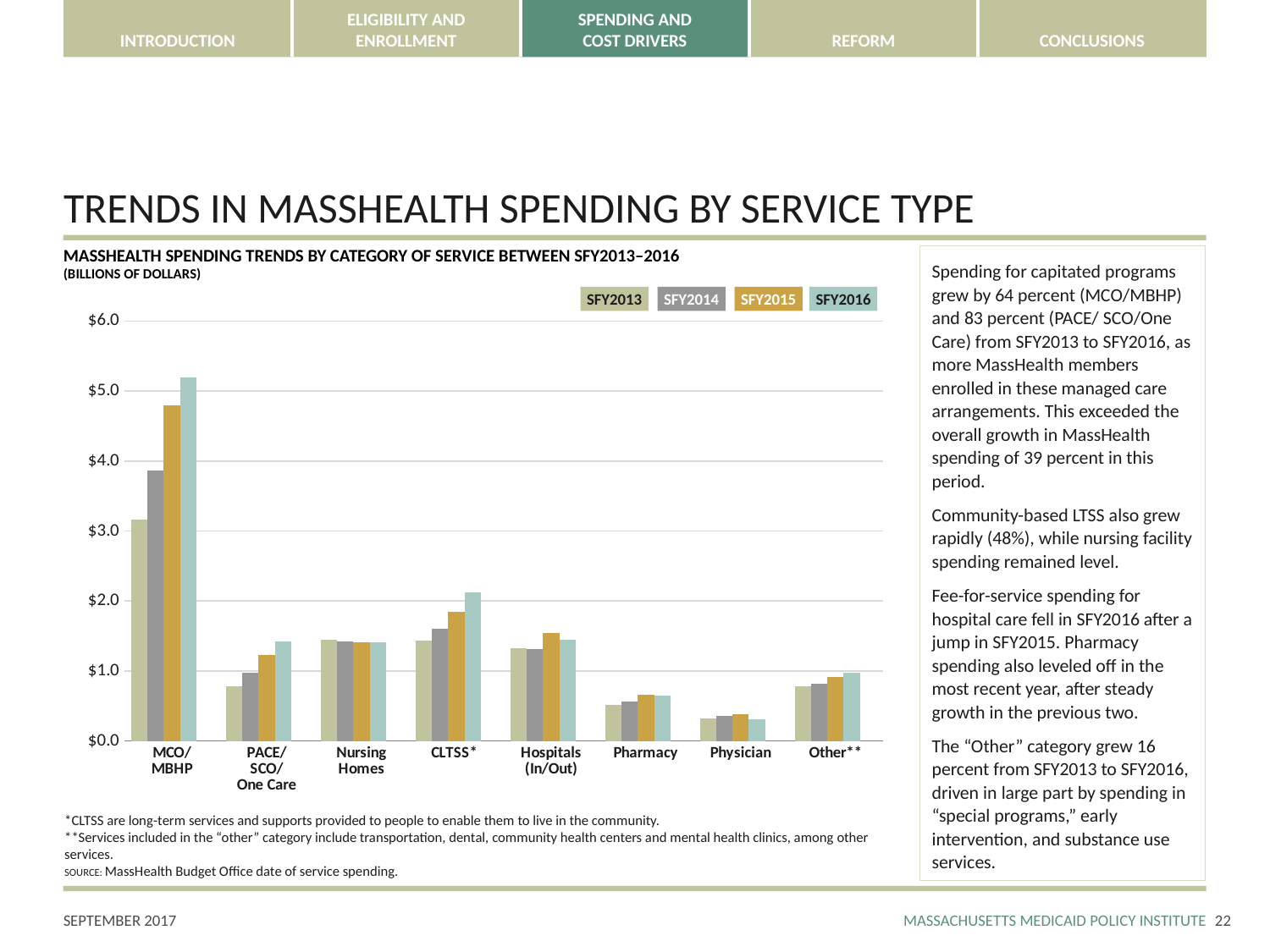
Is the SFY2016 value for MCO/MBHP greater or less than $5.0? greater Which is larger in SFY2016: spending for CLTSS or for Hospitals (In/Out)? CLTSS Which service category has the lowest SFY2016 spending? Physician How many service categories are shown on the x axis of the chart? 8 Do the MCO/MBHP bars rise or fall from SFY2013 to SFY2016? rise Which service category has the highest SFY2016 spending? MCO/MBHP How many series does the chart's legend list? 4 Do the CLTSS bars rise or fall from SFY2013 to SFY2016? rise What kind of chart is shown on the slide? bar chart Is the SFY2015 value for Physician greater or less than $1.0? less What unit does the chart subtitle say the spending values are in? Billions of dollars Is the SFY2013 value for PACE/SCO/One Care greater or less than $1.0? less